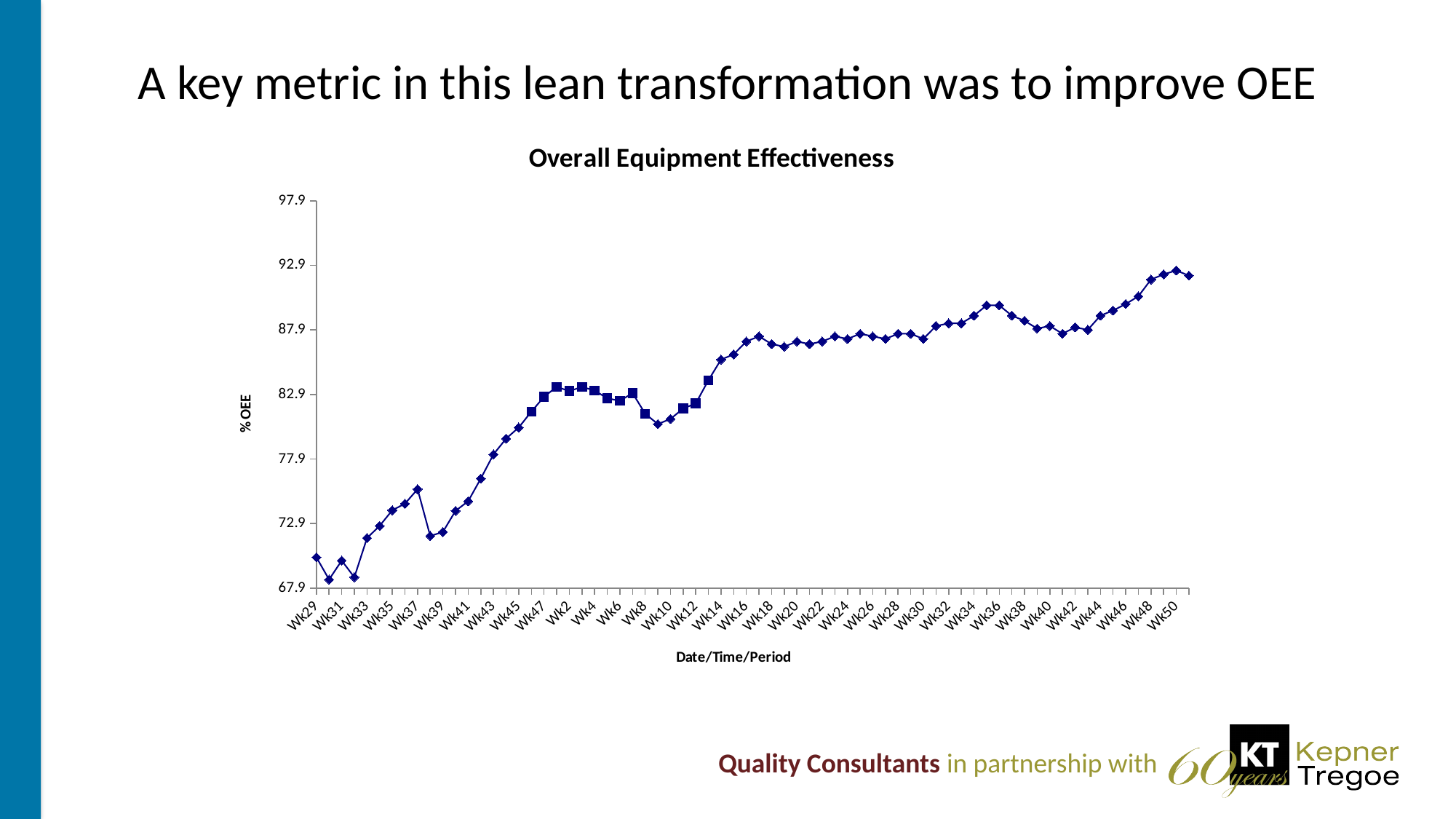
What is the label on the vertical axis of the chart? % OEE Overall, do the OEE values rise or fall from Wk29 to Wk50 along the x axis? rise Which has the higher OEE value, Wk37 or Wk39? Wk37 Is the value for Wk10 greater or less than 82.9? less Is the value for Wk45 greater or less than 77.9? greater What is the title of the chart? Overall Equipment Effectiveness Is the value for Wk48 greater or less than 87.9? greater Which has the higher OEE value, Wk29 or Wk50? Wk50 What kind of chart is shown on the slide? line chart